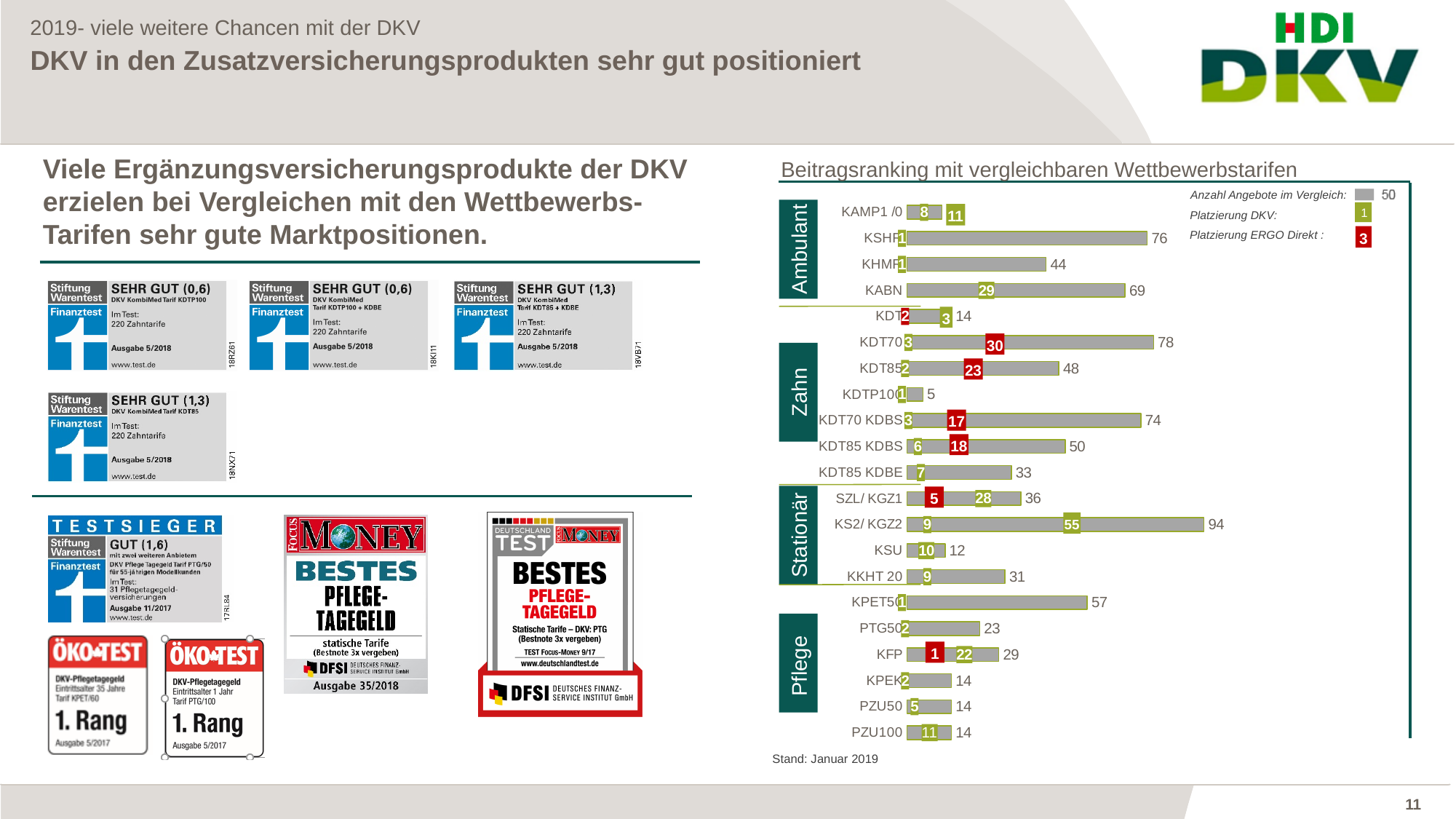
In the Beitragsranking chart, what is the difference between the number of offers for KDT70 and KDT85? 30 In the Beitragsranking chart, which tariff has the lowest number of offers in the comparison? KDTP100 In the Beitragsranking chart, how many offers are in the comparison for KS2/ KGZ2? 94 How many tariffs are listed in the Beitragsranking chart? 21 How many entries does the legend of the Beitragsranking chart list? 3 In the Beitragsranking chart, what is the ERGO Direkt placement for KDT85? 23 In the Beitragsranking chart, what is the DKV placement (Platzierung DKV) for KABN? 29 In the Beitragsranking chart, how many offers are in the comparison for KPET50? 57 What kind of chart is shown under "Beitragsranking mit vergleichbaren Wettbewerbstarifen"? bar chart Which colour marks the ERGO Direkt placement in the Beitragsranking chart? red In the Beitragsranking chart, which tariff has the highest number of offers in the comparison (Anzahl Angebote im Vergleich)? KS2/ KGZ2